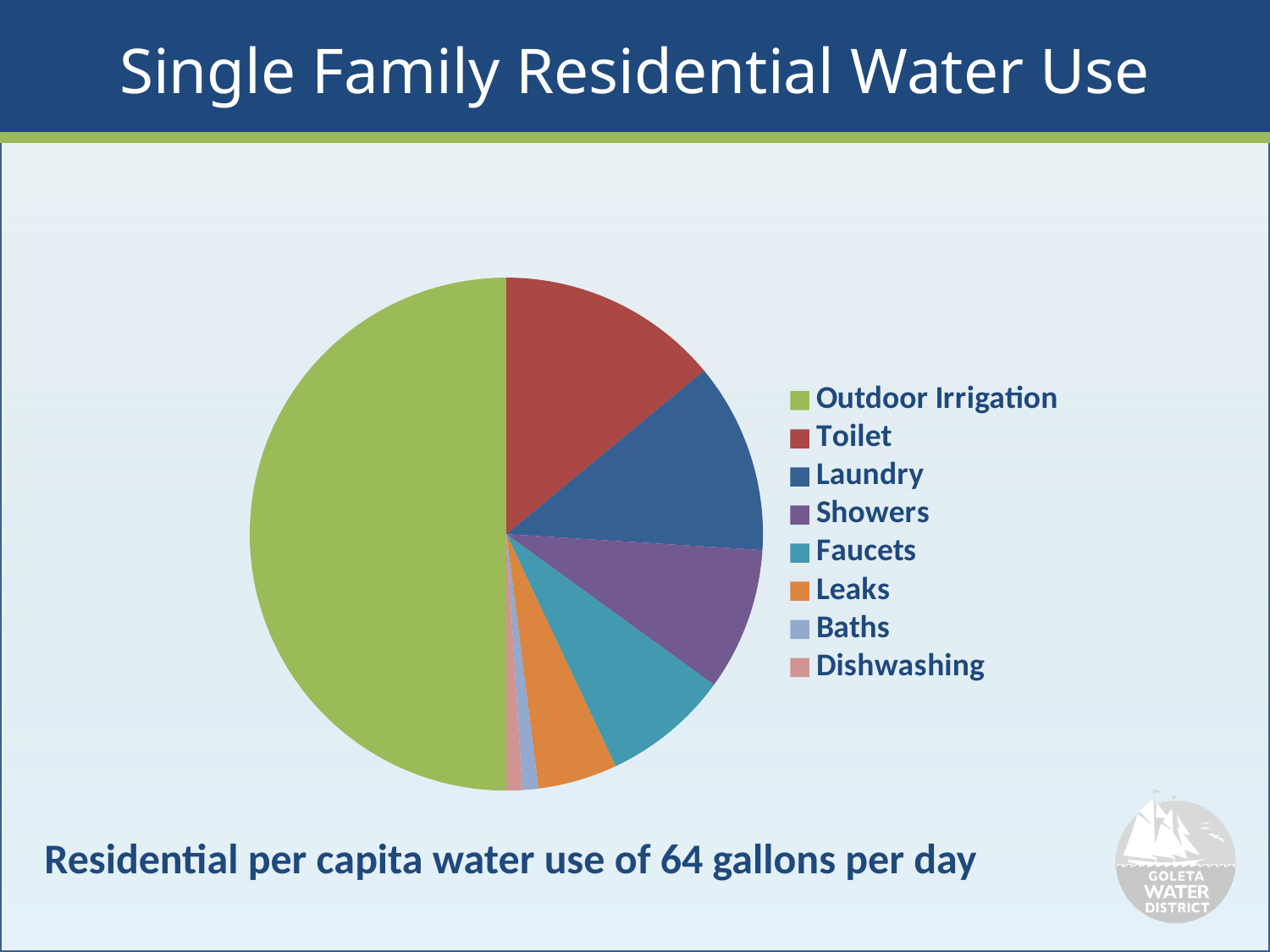
What colour is the Outdoor Irrigation slice in the pie chart? green Which slice is larger, Showers or Faucets? Showers How many categories does the legend of the pie chart list? 8 Which slice is larger, Faucets or Leaks? Faucets What is the title of the slide containing the pie chart? Single Family Residential Water Use Which slice is larger, Laundry or Dishwashing? Laundry According to the text below the chart, what is the residential per capita water use? 64 gallons per day What kind of chart is shown on the slide? pie chart Which category has the largest slice of the pie chart? Outdoor Irrigation